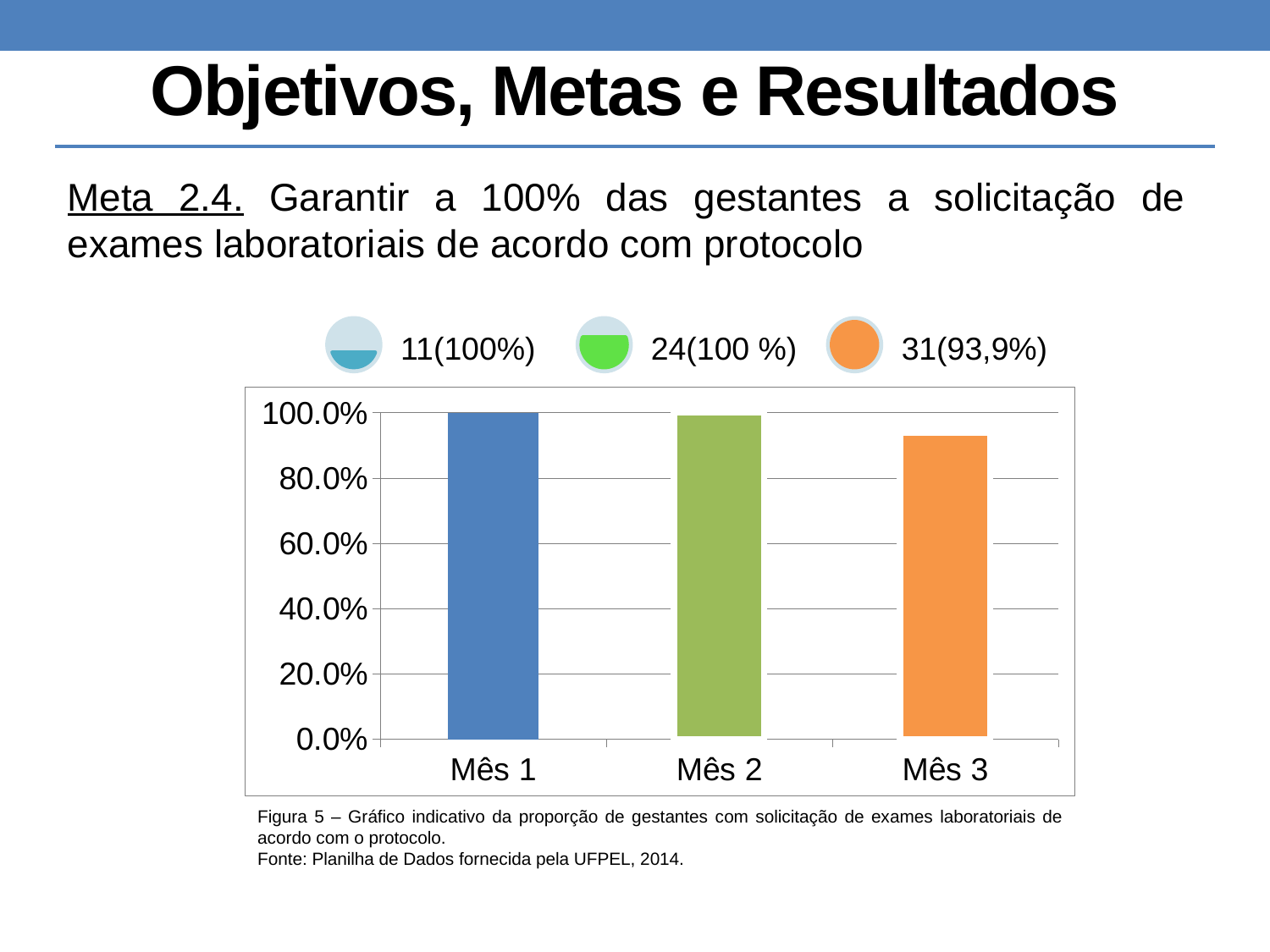
How many categories (months) are plotted on the x axis of the chart? 3 What kind of chart is shown on the slide? bar chart Is the value for Mês 2 greater or less than 60.0%? greater What is the percentage shown for Mês 3? 93,9% Do the bar values rise or fall from Mês 1 to Mês 3? fall How many gestantes are indicated for Mês 3 in the labels above the chart? 31 Is the value for Mês 3 greater or less than 80.0%? greater Which is larger, the value for Mês 1 or the value for Mês 3? Mês 1 Which month has the lowest value in the chart? Mês 3 What colour is the bar for Mês 3? orange What figure number is given in the caption below the chart? Figura 5 What is the percentage shown for Mês 1? 100%